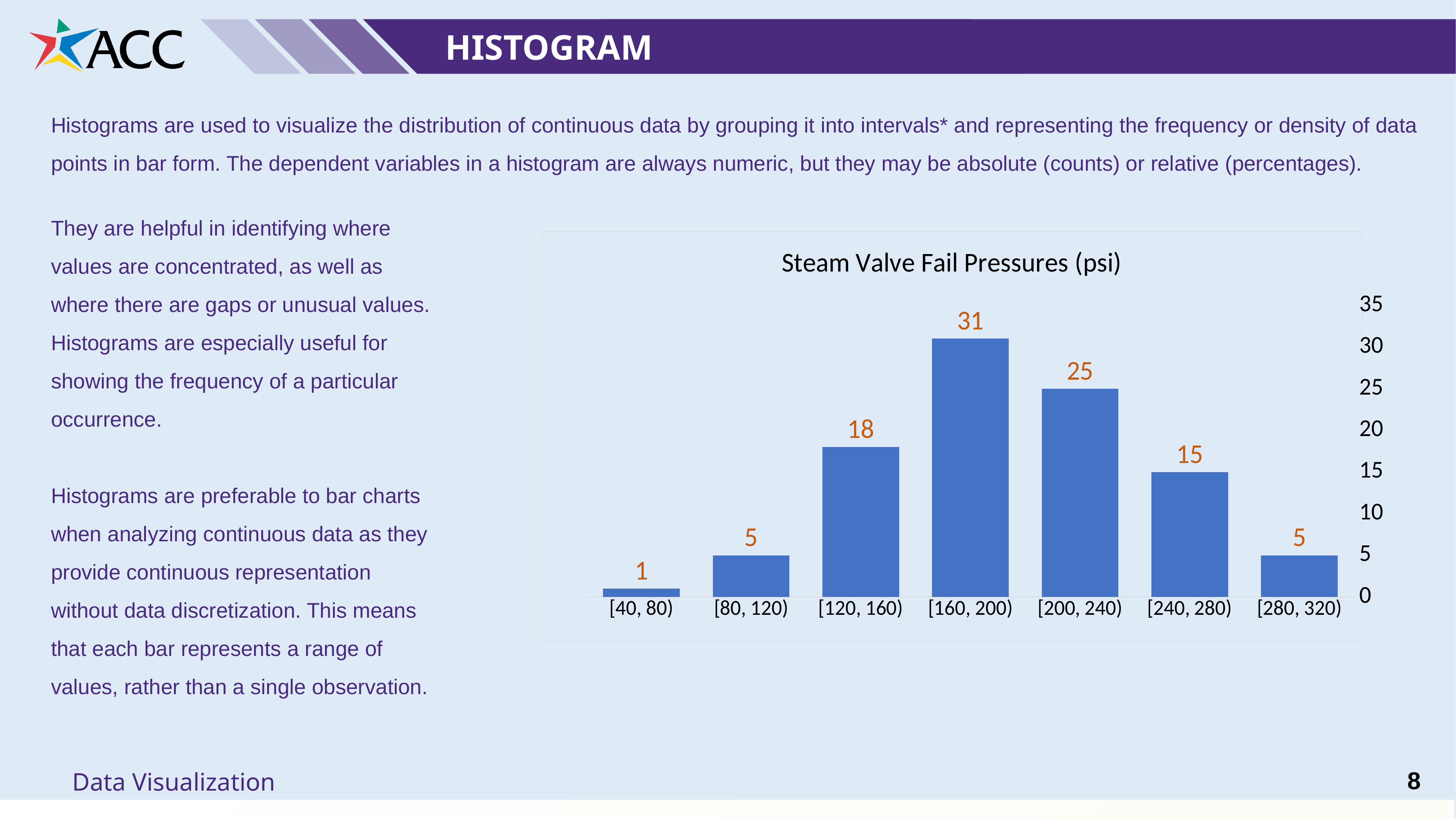
What is the value for the [240, 280) interval? 15 What is the difference between the values for [160, 200) and [200, 240)? 6 Is the value for [200, 240) greater or less than 20? greater Which is larger, the value for [120, 160) or the value for [240, 280)? [120, 160) What is the value for the [160, 200) interval? 31 What is the value for the [40, 80) interval? 1 How many intervals are shown on the x axis? 7 What kind of chart is shown on the slide? bar chart (histogram) Which interval has the lowest value? [40, 80) Do the values rise or fall from [40, 80) to [160, 200)? rise Which interval has the highest value? [160, 200) What is the title of the chart? Steam Valve Fail Pressures (psi)